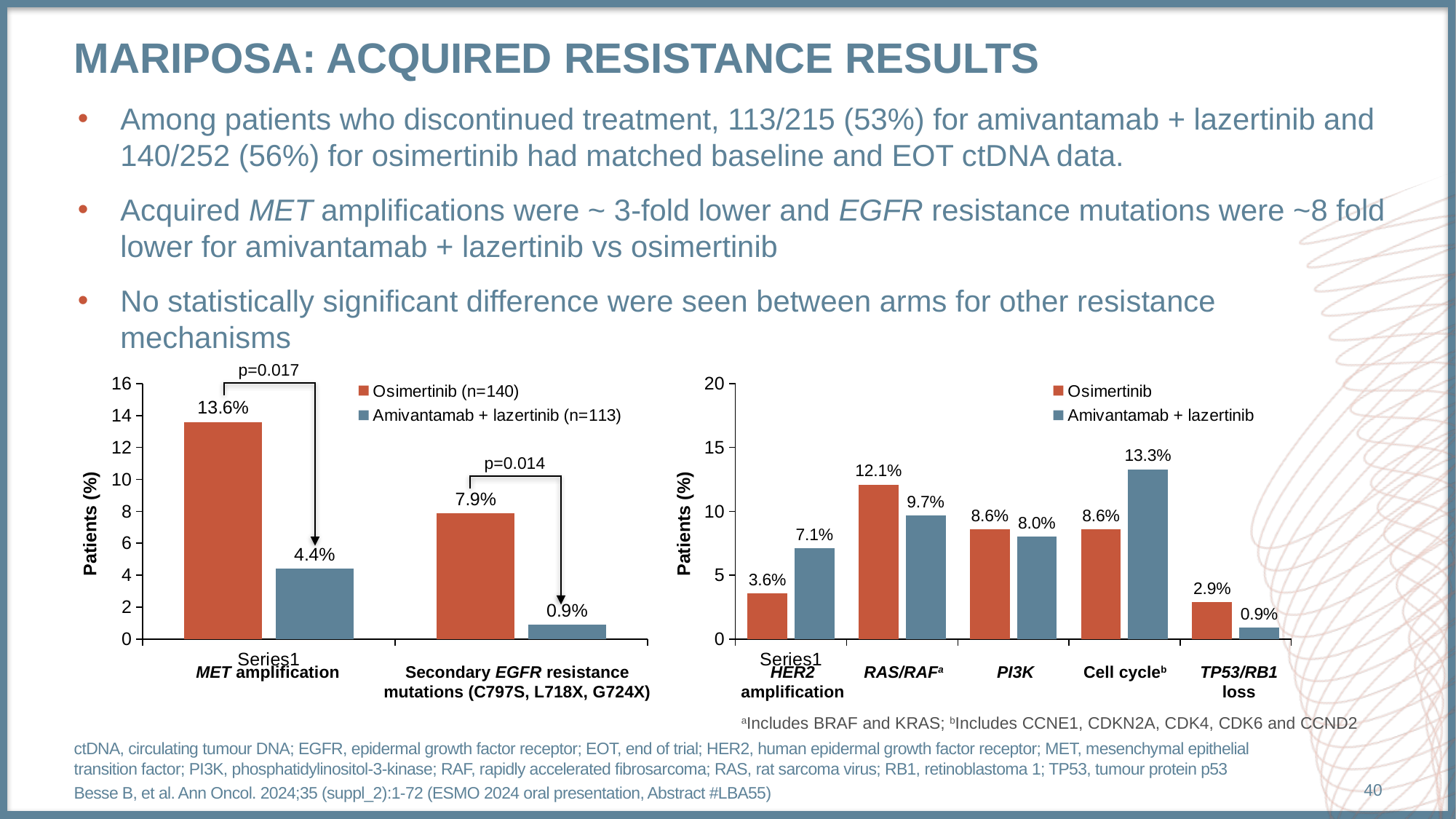
In the left chart, what is the difference between the Osimertinib and Amivantamab + lazertinib values for MET amplification? 9.2% In the left chart, what is the value for Amivantamab + lazertinib for Secondary EGFR resistance mutations? 0.9% In the left chart, how many series does the legend list? 2 In the right chart, which category has the lowest Amivantamab + lazertinib value? TP53/RB1 loss In the right chart, how many categories are shown on the x axis? 5 In the right chart, what is the value for Amivantamab + lazertinib for Cell cycle? 13.3% In the right chart, which category has the highest Osimertinib value? RAS/RAF In the right chart, which is larger for HER2 amplification: Osimertinib or Amivantamab + lazertinib? Amivantamab + lazertinib What kind of chart is the right chart? Bar chart In the right chart, what is the value for Osimertinib for RAS/RAF? 12.1% In the right chart, what is the difference between the Osimertinib and Amivantamab + lazertinib values for PI3K? 0.6% In the left chart, what is the value for Osimertinib for MET amplification? 13.6%